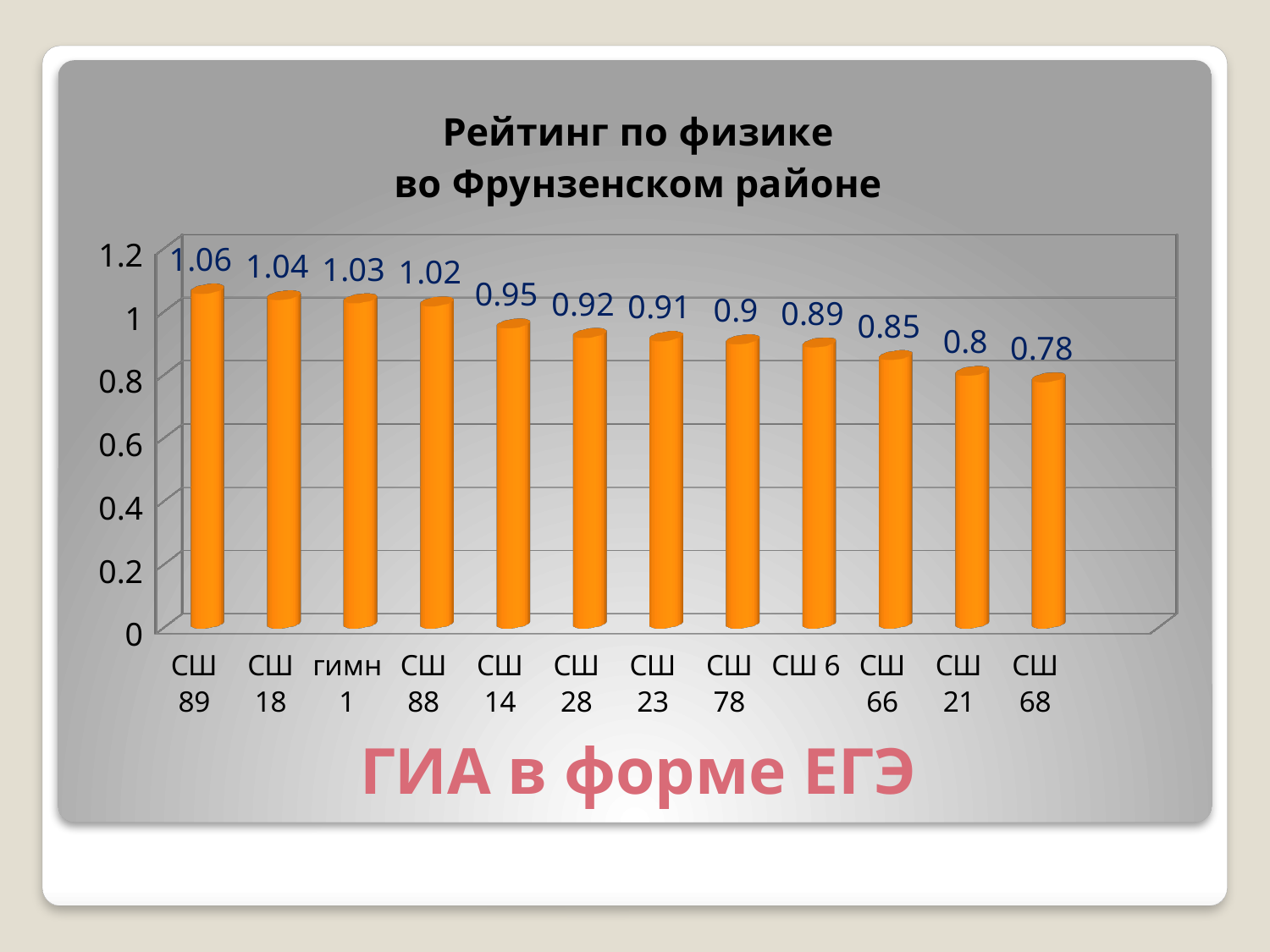
Which is larger, the value for СШ 14 or the value for СШ 21? СШ 14 What is the value for СШ 89? 1.06 Do the values rise or fall from left to right along the x axis? fall Which category has the highest value? СШ 89 What is the difference between the values for СШ 89 and СШ 68? 0.28 Which category has the lowest value? СШ 68 What is the value for гимн 1? 1.03 What is the value for СШ 66? 0.85 What is the title of the chart? Рейтинг по физике во Фрунзенском районе What kind of chart is shown on the slide? bar chart Is the value for СШ 6 greater or less than 1? less How many categories are shown on the x axis? 12